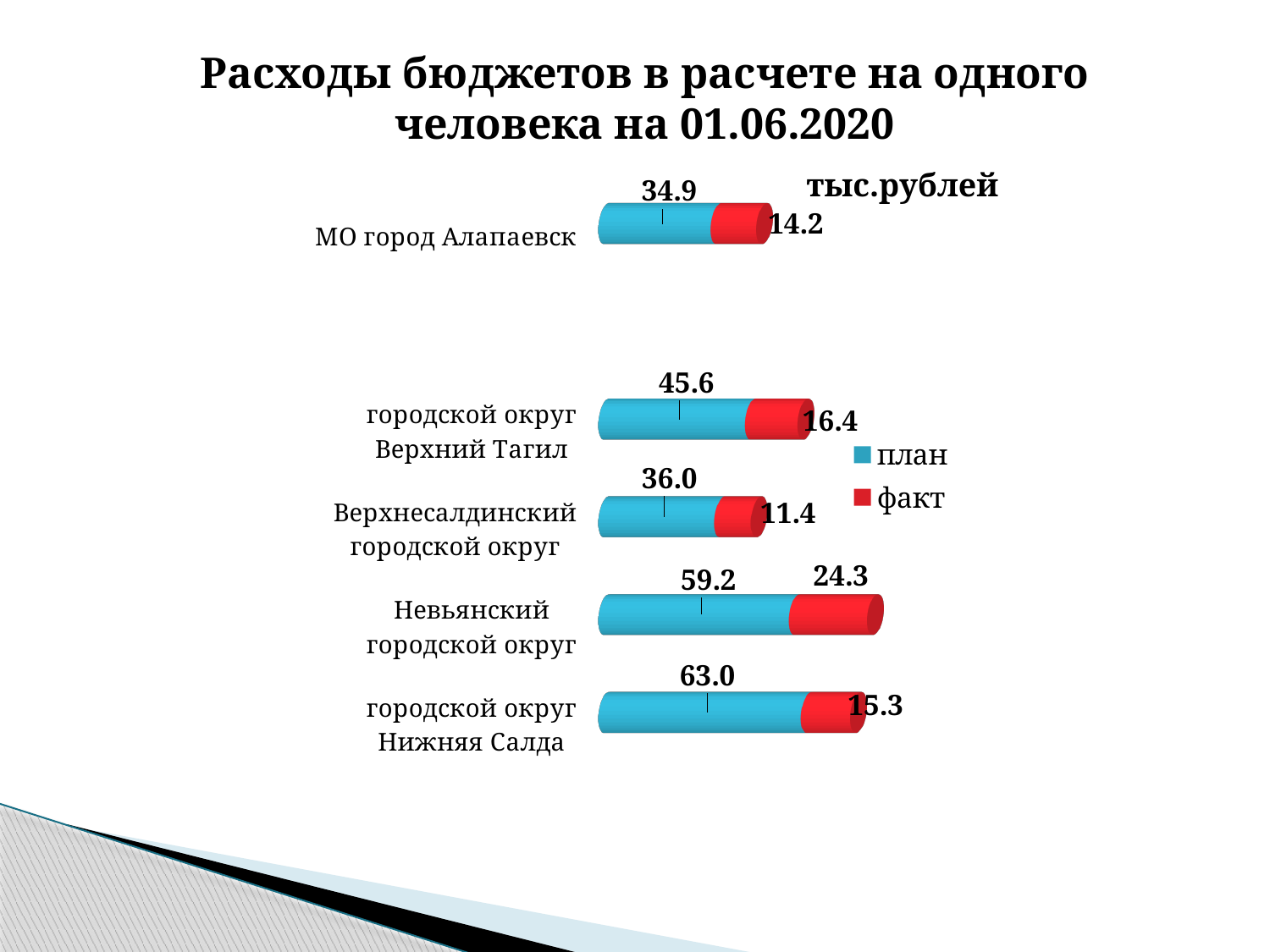
What is the факт value for Невьянский городской округ? 24.3 Which is larger: the факт value for городской округ Верхний Тагил or for городской округ Нижняя Салда? городской округ Верхний Тагил What kind of chart is shown on the slide? bar chart Which category has the lowest факт value? Верхнесалдинский городской округ What is the план value for МО город Алапаевск? 34.9 Which category has the highest факт value? Невьянский городской округ How many series does the legend list? 2 What is the факт value for Верхнесалдинский городской округ? 11.4 How many categories are shown in the chart? 5 What is the план value for городской округ Нижняя Салда? 63.0 Which category has the highest план value? городской округ Нижняя Салда What is the difference between the план and факт values for городской округ Нижняя Салда? 47.7